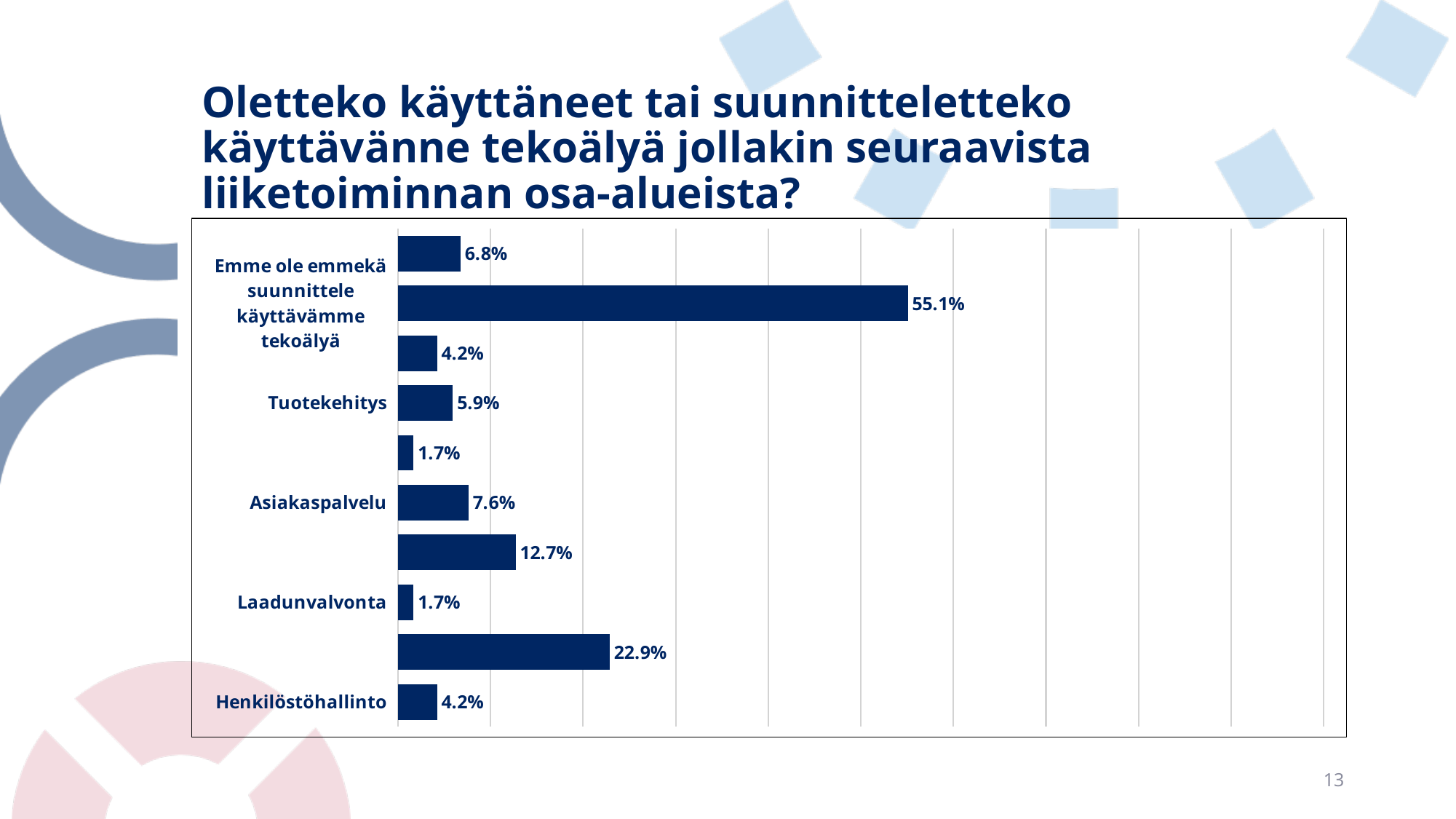
What is the value for 'Emme ole emmekä suunnittele käyttävämme tekoälyä'? 55.1% What kind of chart is shown on the slide? bar chart Which category has the highest value in the chart? Emme ole emmekä suunnittele käyttävämme tekoälyä What is the difference between the values for Asiakaspalvelu and Laadunvalvonta? 5.9% What is the value for Laadunvalvonta? 1.7% What is the value for Asiakaspalvelu? 7.6% What is the largest value shown in the chart? 55.1% Which is larger, the value for Asiakaspalvelu or the value for Tuotekehitys? Asiakaspalvelu What is the value for Henkilöstöhallinto? 4.2% How many bars are plotted in the chart? 10 What is the difference between the values for Henkilöstöhallinto and Laadunvalvonta? 2.5% What is the value for Tuotekehitys? 5.9%